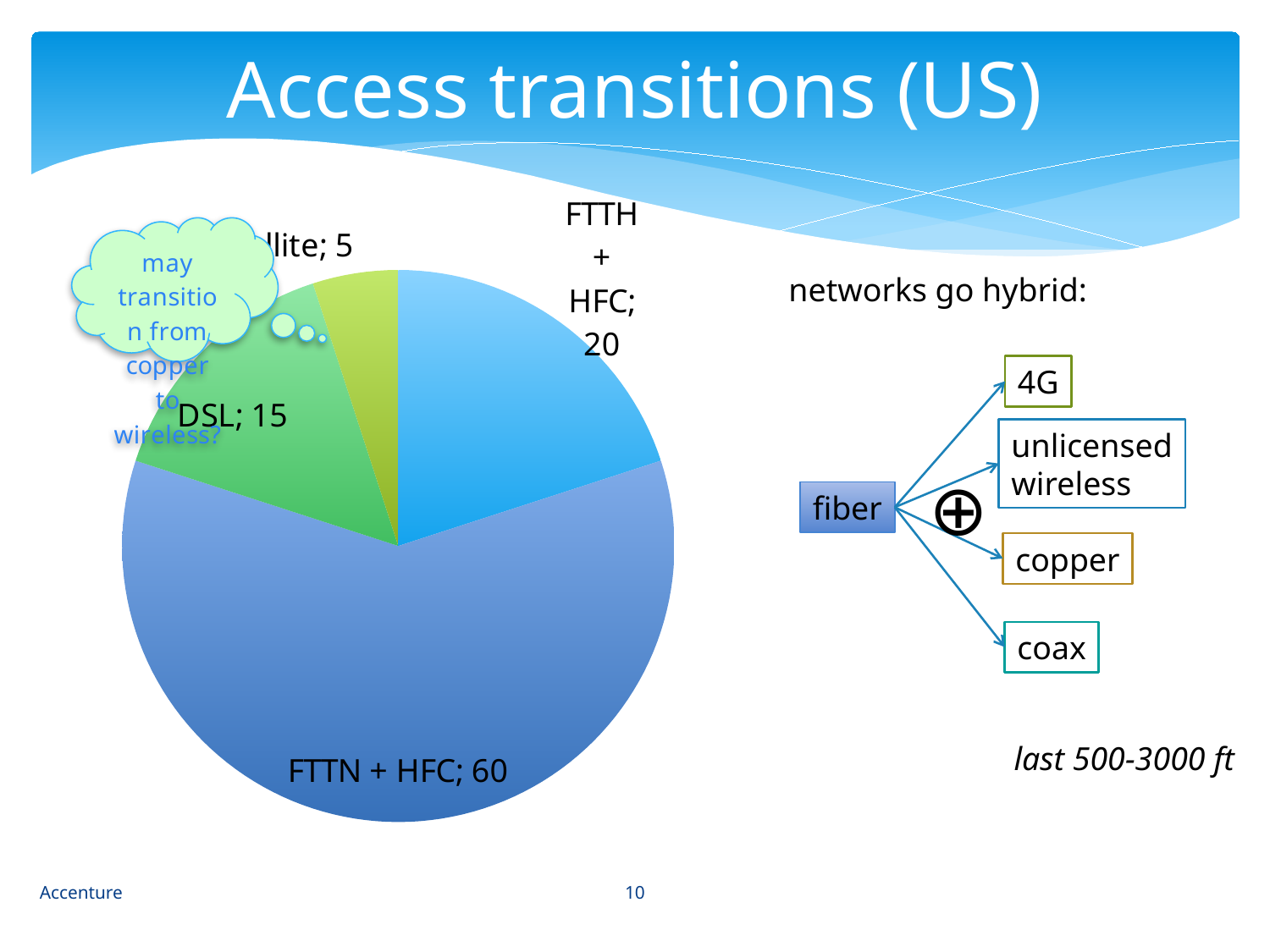
What kind of chart is shown on the slide? Pie chart What colour is the FTTN + HFC slice of the pie chart? Blue What is the total of all the slice values in the pie chart? 100 What is the difference between the FTTH + HFC value and the DSL value in the pie chart? 5 What is the difference between the FTTN + HFC value and the FTTH + HFC value in the pie chart? 40 Which slice of the pie chart is the largest? FTTN + HFC Which is larger in the pie chart, the DSL slice or the FTTH + HFC slice? FTTH + HFC How many slices does the pie chart have? 4 What value is shown for the FTTN + HFC slice of the pie chart? 60 What value is shown for the FTTH + HFC slice of the pie chart? 20 What share of the pie chart does the FTTN + HFC slice represent? 60% What value is shown for the DSL slice of the pie chart? 15